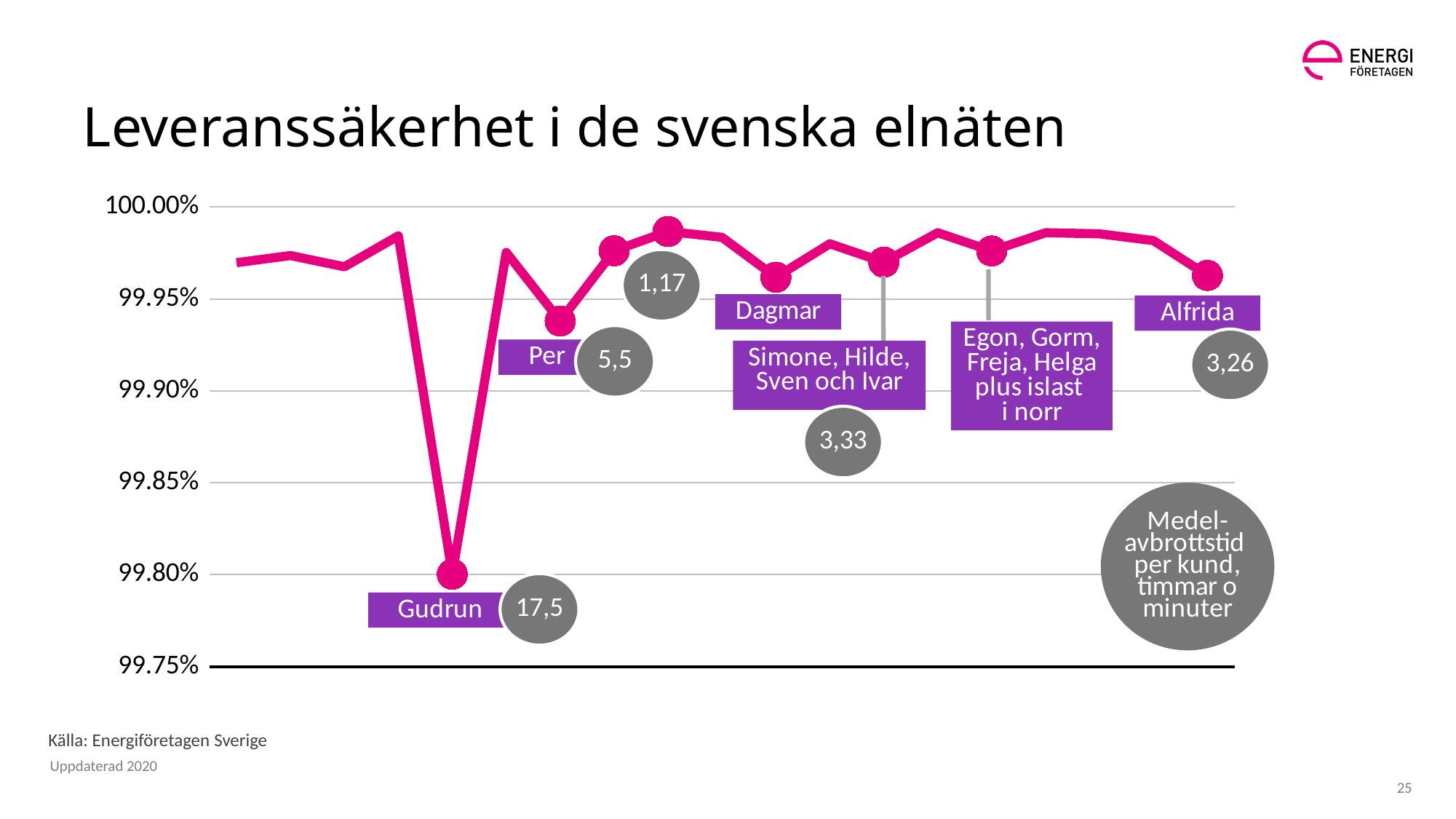
Is the value of the line at the Gudrun point greater or less than 99.85%? less What kind of chart is shown on the slide? line chart Which named storm corresponds to the lowest point on the line? Gudrun What average outage time per customer (grey circle) is shown next to Alfrida? 3,26 According to the grey circle legend, what do the grey circle values represent? Medelavbrottstid per kund, timmar o minuter What average outage time per customer (grey circle) is shown for Simone, Hilde, Sven och Ivar? 3,33 What average outage time per customer (grey circle) is shown next to Gudrun? 17,5 What average outage time per customer (grey circle) is shown next to Per? 5,5 Is the value of the line at the Per point greater or less than 99.90%? greater What is the title of the slide's chart? Leveranssäkerhet i de svenska elnäten Which has the larger average outage time per customer, Gudrun or Per? Gudrun What is the difference between the average outage times shown for Gudrun (17,5) and Per (5,5)? 12